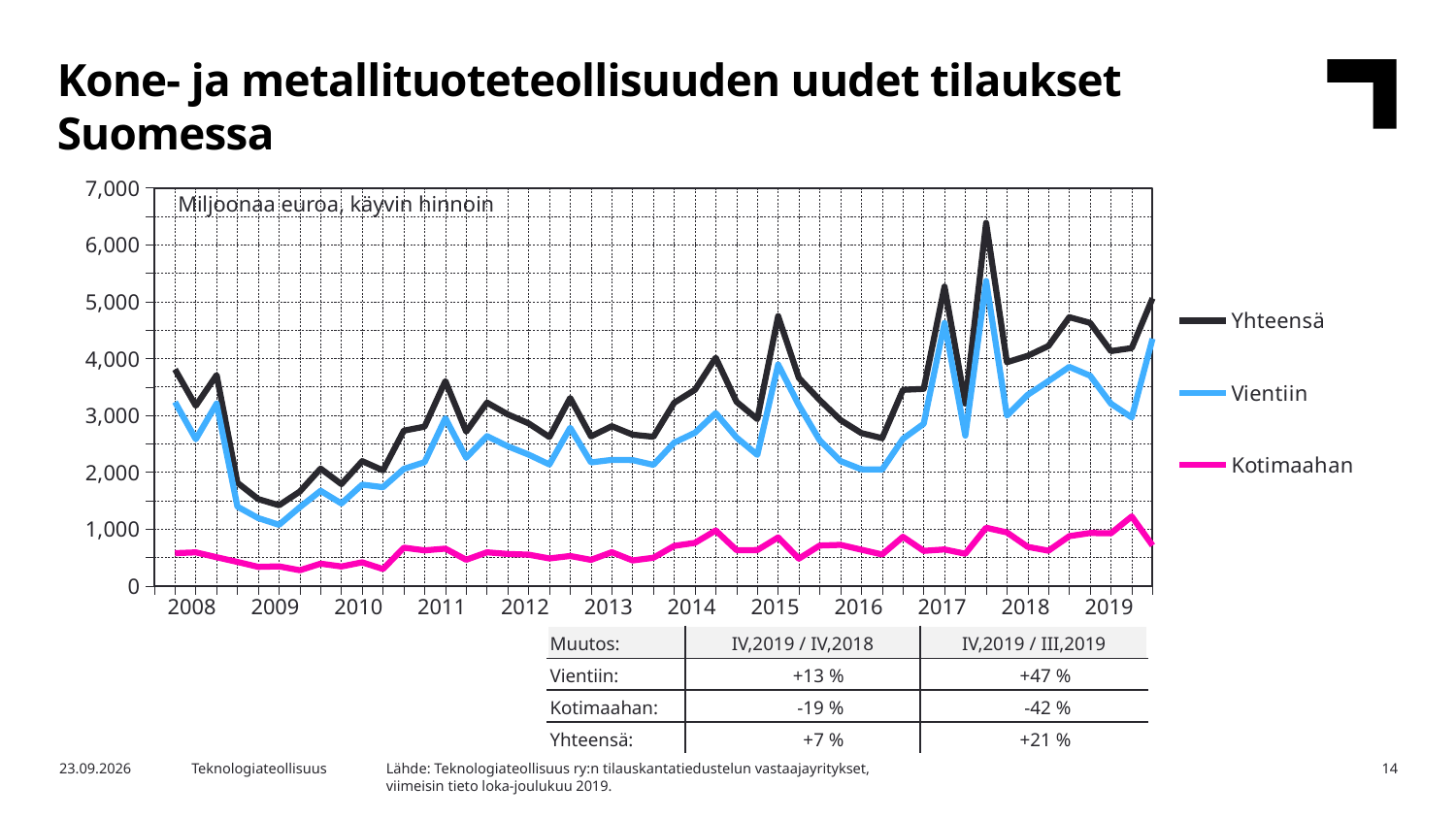
What unit label is printed inside the chart area? Miljoonaa euroa, käyvin hinnoin How many years are labelled on the x axis? 12 Which series has the lowest values throughout the chart? Kotimaahan How many series does the legend list? 3 Which series is larger in 2019, Vientiin or Kotimaahan? Vientiin Is the Kotimaahan line ever greater or less than 2,000 across the whole chart? less Is the lowest value of the Yhteensä line in 2009 greater or less than 2,000? less Which series has the highest values throughout the chart? Yhteensä Is the peak value of the Yhteensä line in 2017 greater or less than 6,000? greater What are the three series named in the legend? Yhteensä, Vientiin, Kotimaahan What kind of chart is shown on the slide? line chart